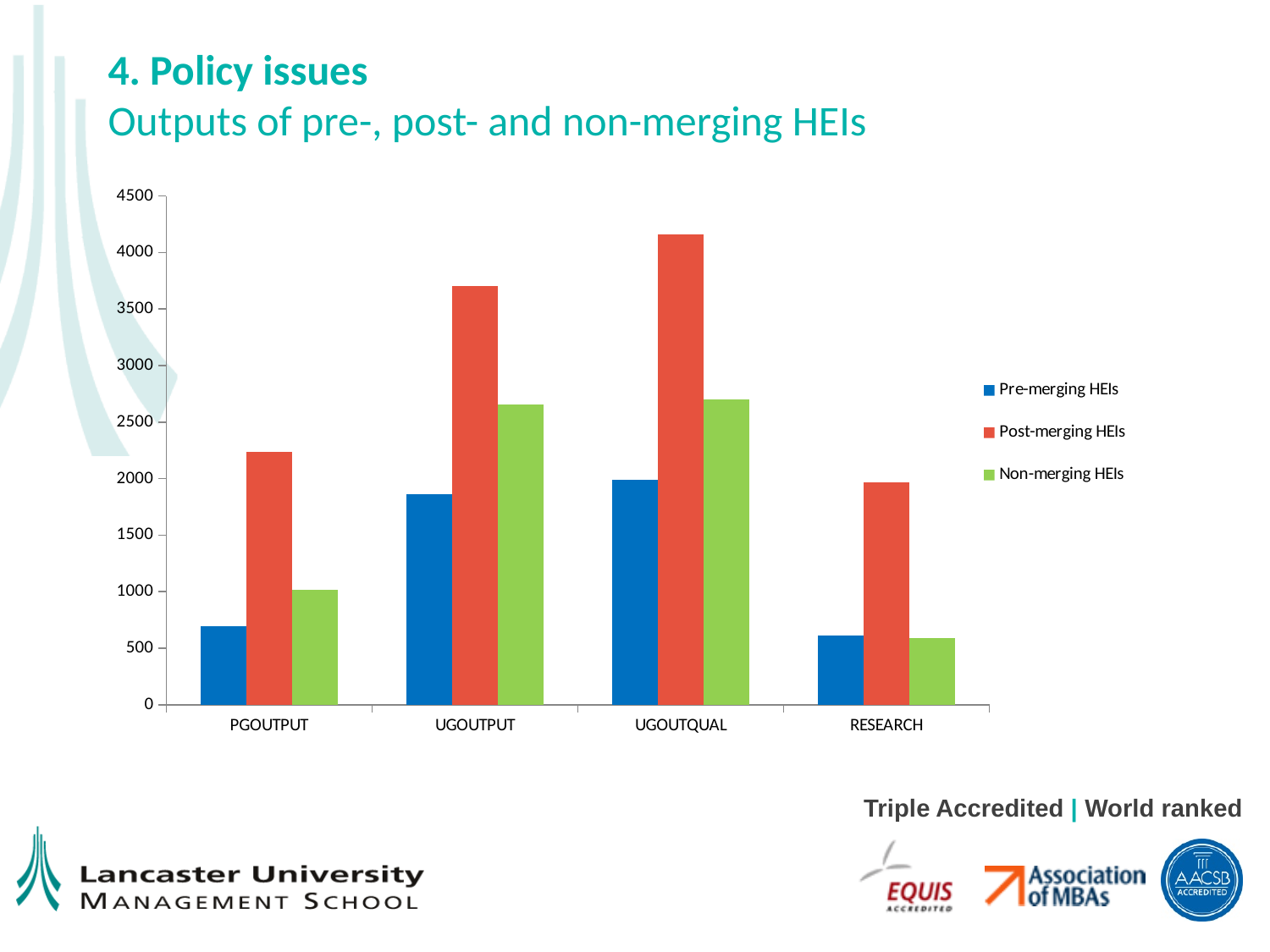
What kind of chart is shown on the slide? bar chart For UGOUTPUT, which is larger: the Post-merging HEIs value or the Non-merging HEIs value? Post-merging HEIs How many series does the chart's legend list? 3 Is the Post-merging HEIs value for UGOUTPUT greater or less than 3500? greater Which colour represents Post-merging HEIs in the chart's legend? red How many categories are shown on the x axis of the chart? 4 Is the Post-merging HEIs value for PGOUTPUT greater or less than 2000? greater Is the Post-merging HEIs value for UGOUTQUAL greater or less than 4000? greater For which category is the Non-merging HEIs bar lowest? RESEARCH For which category is the Post-merging HEIs bar highest? UGOUTQUAL